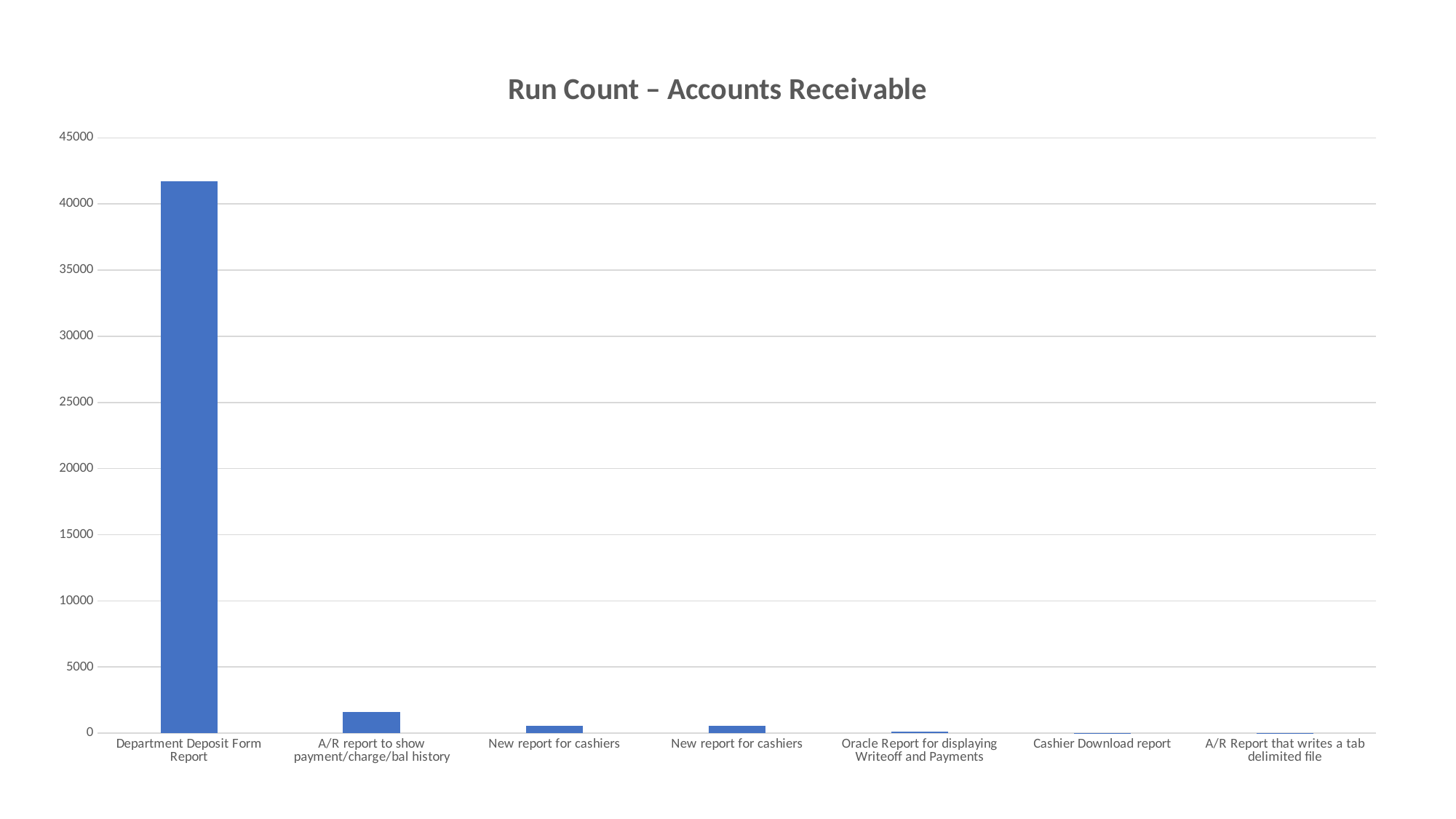
Which is larger, the value for A/R report to show payment/charge/bal history or the value for Oracle Report for displaying Writeoff and Payments? A/R report to show payment/charge/bal history Is the value for Department Deposit Form Report greater or less than 45000? less Do the values generally rise or fall from left to right along the x axis? fall What kind of chart is shown on the slide? bar chart Which category has the highest run count? Department Deposit Form Report Is the value for Cashier Download report greater or less than 5000? less Which is larger, the value for Department Deposit Form Report or the value for A/R report to show payment/charge/bal history? Department Deposit Form Report Is the value for A/R report to show payment/charge/bal history greater or less than 5000? less What is the highest value shown on the vertical axis? 45000 What is the title of the chart? Run Count – Accounts Receivable How many categories are plotted on the x axis? 7